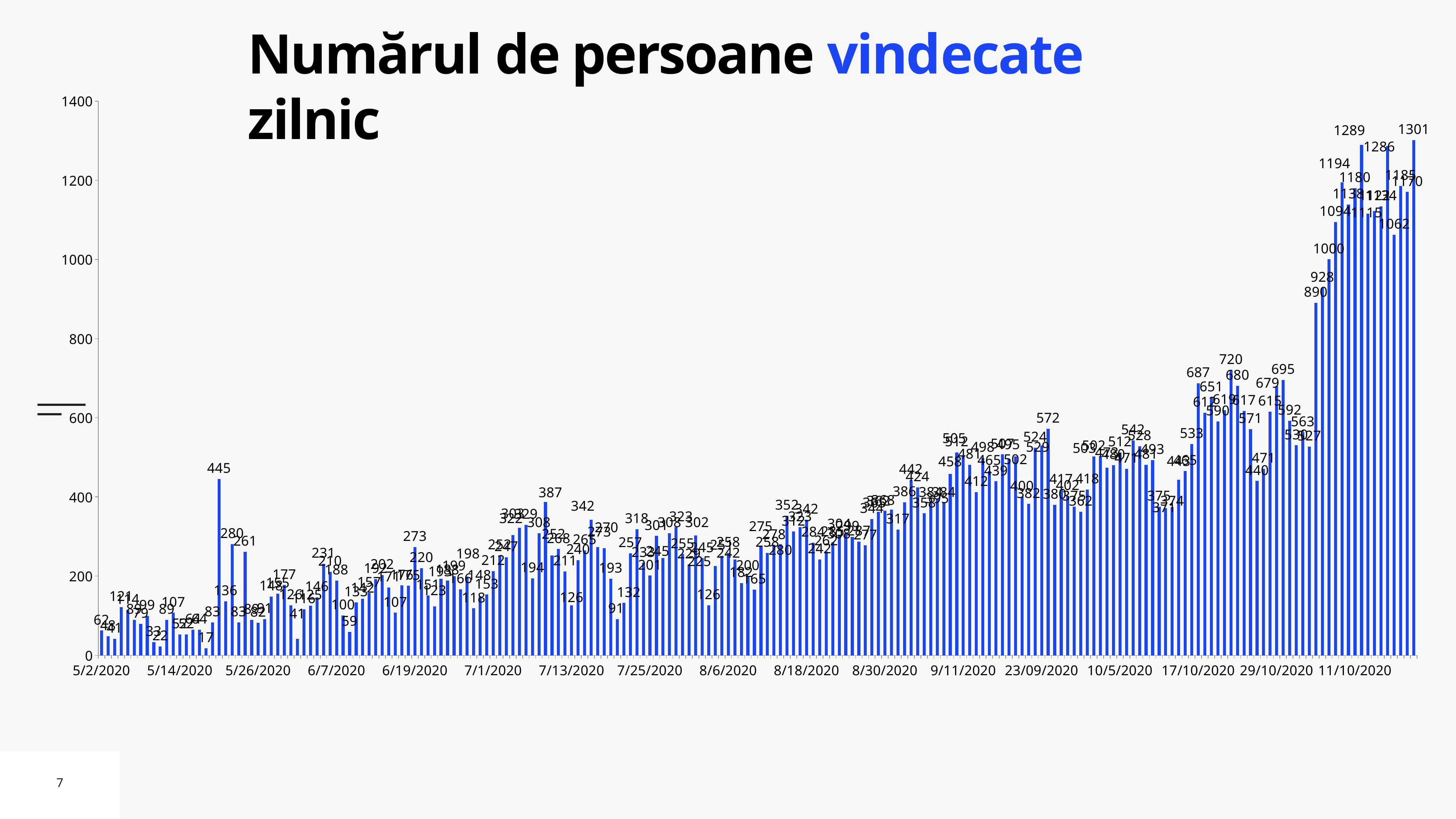
What is the highest tick value shown on the y axis? 1400 What kind of chart is shown on the slide? bar chart Is the highest value in the chart greater or less than 1200? greater Do the values generally rise or fall from left to right along the x axis? rise What is the lowest daily value labeled in the chart? 17 What is the value for 5/2/2020, the first bar in the chart? 62 What is the difference between the highest value (1301) and the lowest value (17) in the chart? 1284 Is the value for 5/2/2020 greater or less than 200? less Which is larger, the May spike labeled 445 or the July peak labeled 387? 445 What is the title of the chart? Numărul de persoane vindecate zilnic What is the difference between the two highest labeled values, 1301 and 1289? 12 What is the highest daily value shown in the chart? 1301